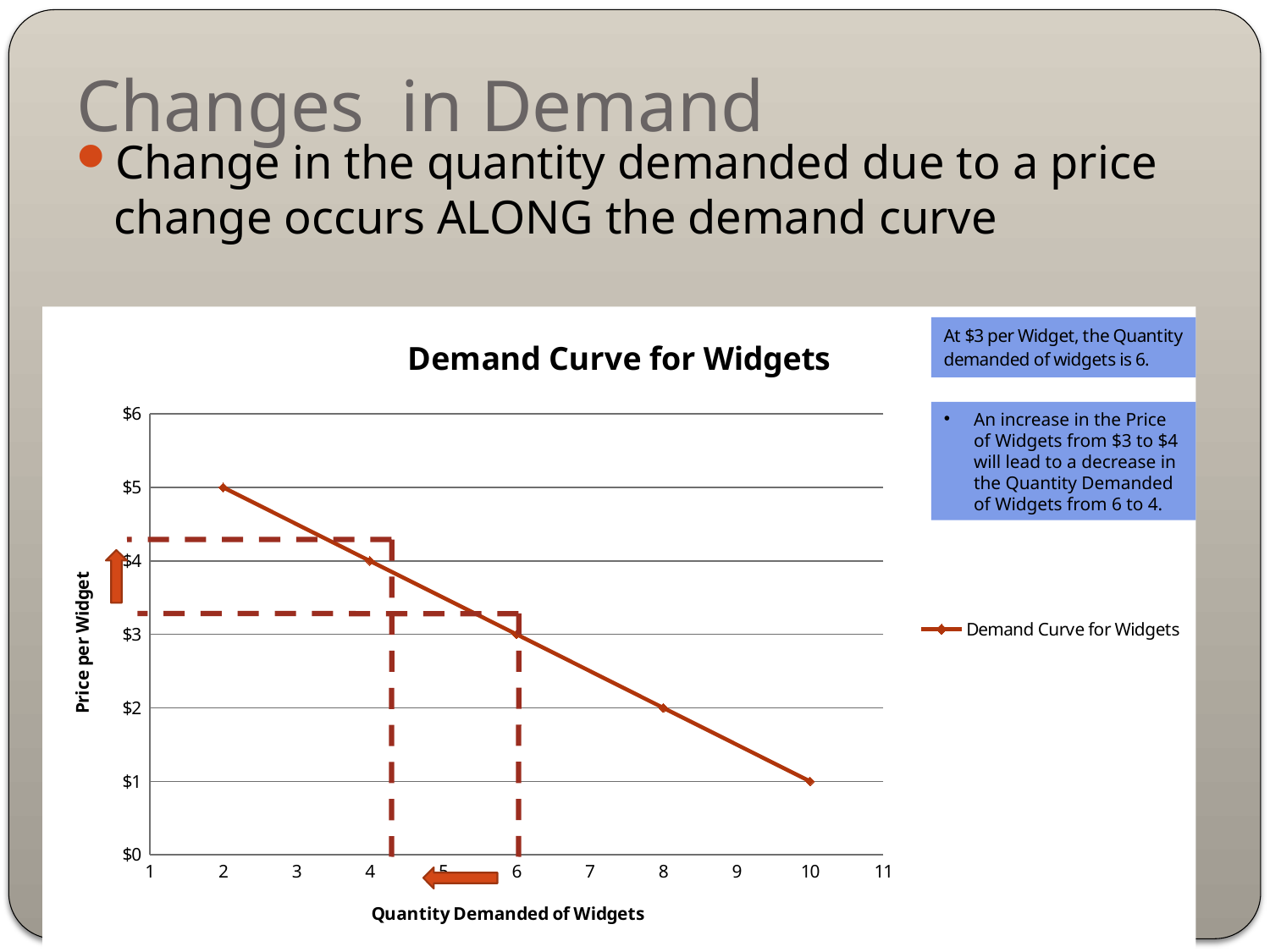
How many series does the legend list? 1 At which quantity demanded is the price per widget lowest? 10 At which quantity demanded is the price per widget highest? 2 Which is higher: the price at a quantity of 4 or the price at a quantity of 8? the price at a quantity of 4 What is the quantity demanded of widgets at a price of $1? 10 What is the price per widget when the quantity demanded is 2? $5 What is the price per widget when the quantity demanded is 6? $3 Does the price per widget rise or fall as the quantity demanded increases along the x axis? fall How many data points are plotted on the demand curve? 5 What type of chart is shown on the slide? line chart What is the difference in price per widget between a quantity demanded of 4 and a quantity demanded of 6? $1 What is the title of the chart? Demand Curve for Widgets